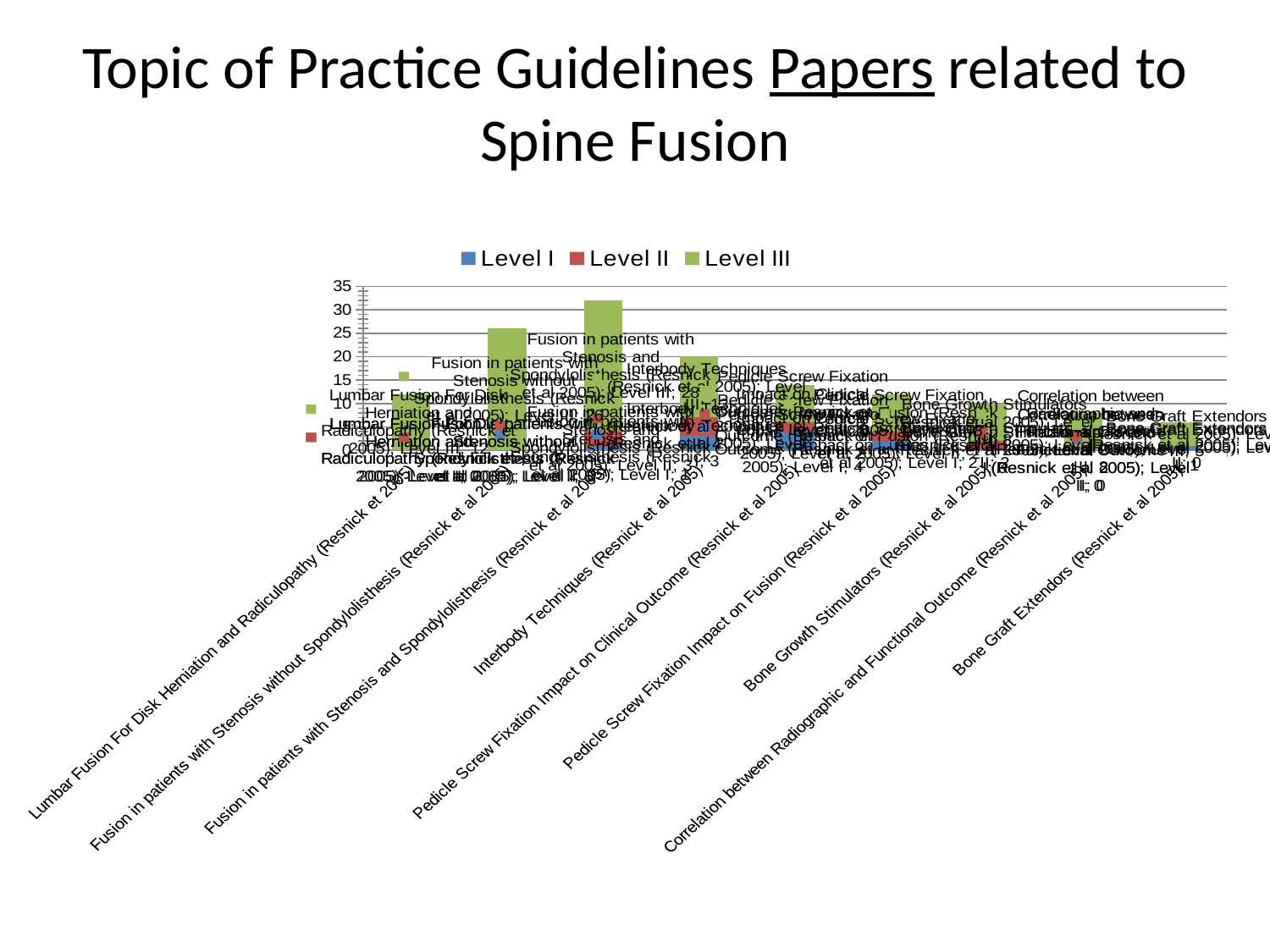
Which category has the highest Level III value? Fusion in patients with Stenosis and Spondylolisthesis (Resnick et al 2005) What is the title of the slide containing the chart? Topic of Practice Guidelines Papers related to Spine Fusion Which series generally has the tallest bars across the categories? Level III What are the series names listed in the legend? Level I, Level II, Level III Is the Level III value for Fusion in patients with Stenosis without Spondylolisthesis (Resnick et al 2005) greater or less than 20? greater Which is larger, the Level III value for Fusion in patients with Stenosis and Spondylolisthesis (Resnick et al 2005) or the Level III value for Bone Growth Stimulators (Resnick et al 2005)? Fusion in patients with Stenosis and Spondylolisthesis (Resnick et al 2005) What is the maximum value shown on the vertical axis? 35 How many topic categories are shown along the x axis? 9 Is the Level III value for Fusion in patients with Stenosis and Spondylolisthesis (Resnick et al 2005) greater or less than 25? greater What kind of chart is shown on the slide? bar chart Is the Level III value for Bone Graft Extendors (Resnick et al 2005) greater or less than 10? less How many series does the legend list? 3